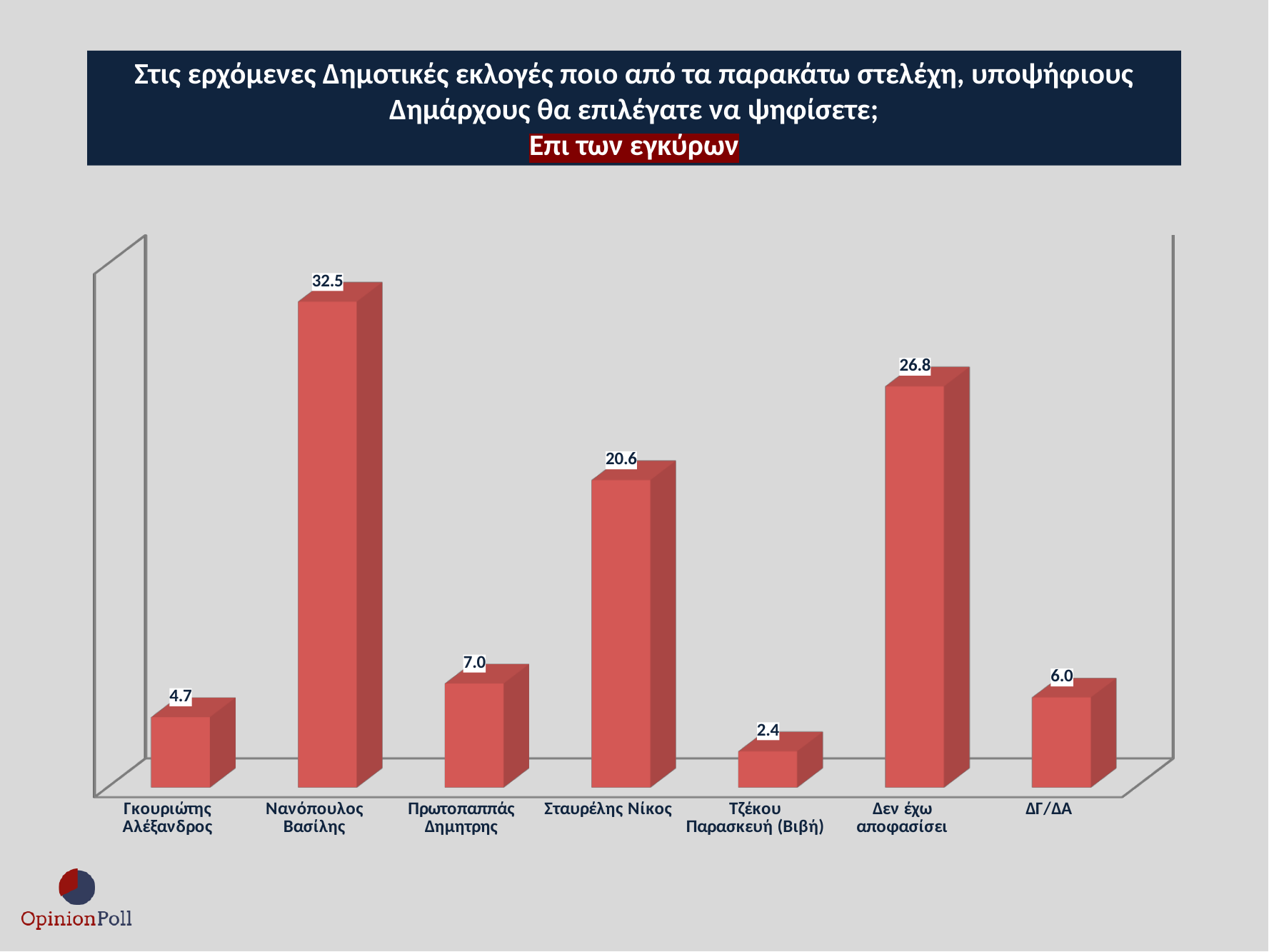
What is the value for Τζέκου Παρασκευή (Βιβή)? 2.4 What is the value for ΔΓ/ΔΑ? 6.0 What is the difference between the values for Πρωτοπαππάς Δημήτρης and Γκουριώτης Αλέξανδρος? 2.3 Which category has the lowest value? Τζέκου Παρασκευή (Βιβή) What is the value for Νανόπουλος Βασίλης? 32.5 What is the value for Δεν έχω αποφασίσει? 26.8 Which category has the highest value? Νανόπουλος Βασίλης What is the difference between the values for Νανόπουλος Βασίλης and Σταυρέλης Νίκος? 11.9 What kind of chart is shown on the slide? Bar chart What colour are the bars in the chart? Red Which is larger, the value for Σταυρέλης Νίκος or the value for Δεν έχω αποφασίσει? Δεν έχω αποφασίσει How many categories are shown on the x axis? 7